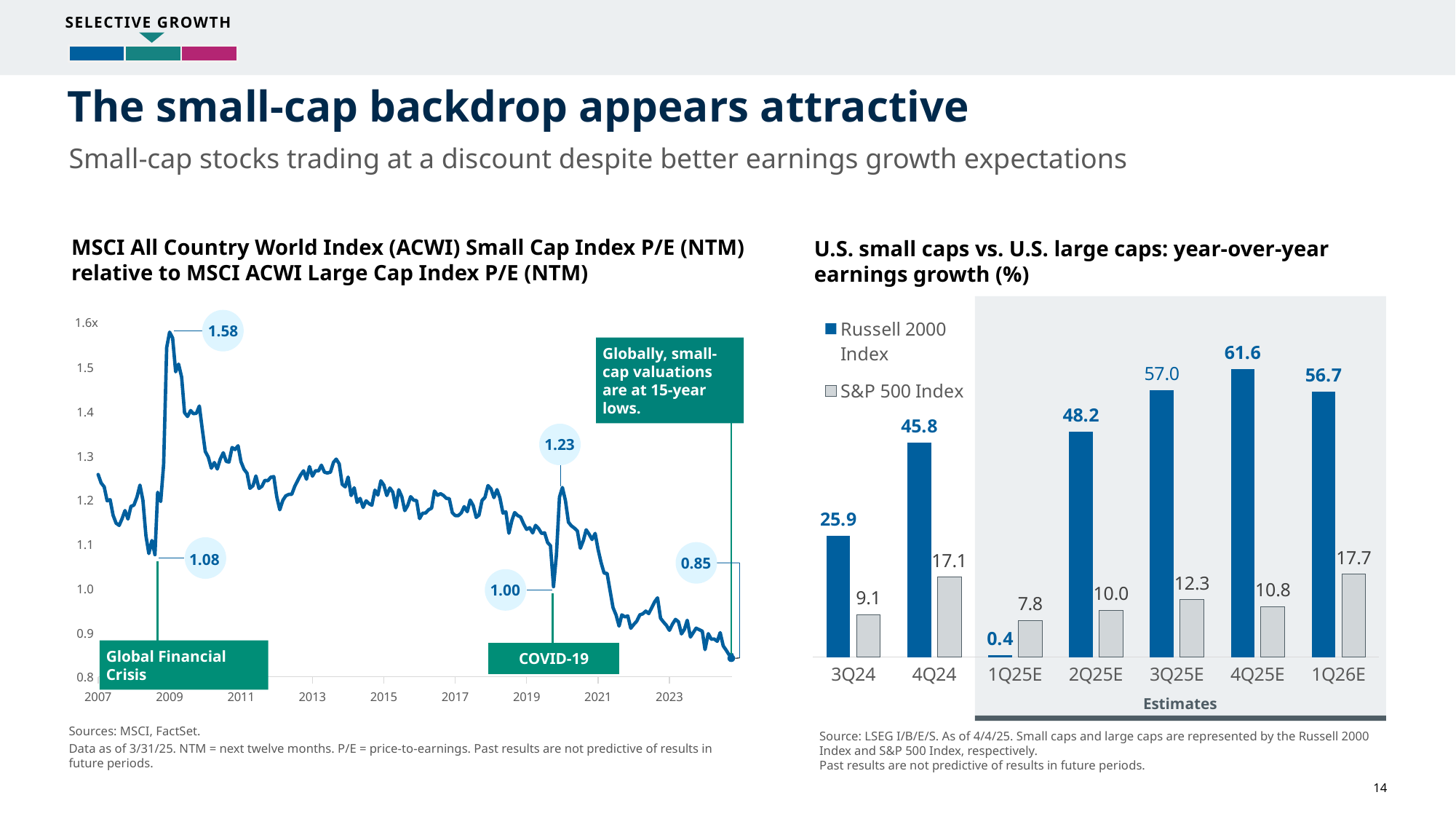
In the 'U.S. small caps vs. U.S. large caps' chart, what is the difference between the Russell 2000 Index and S&P 500 Index values for 4Q24? 28.7 In the MSCI ACWI Small Cap relative P/E chart, what is the labelled peak value reached around 2009? 1.58 In the 'U.S. small caps vs. U.S. large caps' chart, what is the Russell 2000 Index value for 4Q25E? 61.6 In the 'U.S. small caps vs. U.S. large caps' chart, which is larger for 1Q25E: the Russell 2000 Index value or the S&P 500 Index value? S&P 500 Index What kind of chart is the MSCI ACWI Small Cap relative P/E chart? Line chart What kind of chart is the 'U.S. small caps vs. U.S. large caps' chart? Bar chart In the 'U.S. small caps vs. U.S. large caps' chart, how many series does the legend list? 2 In the MSCI ACWI Small Cap relative P/E chart, what is the labelled value at the end of the series? 0.85 In the 'U.S. small caps vs. U.S. large caps' chart, which quarter has the highest Russell 2000 Index value? 4Q25E In the 'U.S. small caps vs. U.S. large caps' chart, how many quarters are shown on the x axis? 7 In the 'U.S. small caps vs. U.S. large caps' chart, what is the S&P 500 Index value for 3Q24? 9.1 In the 'U.S. small caps vs. U.S. large caps' chart, which quarter has the lowest Russell 2000 Index value? 1Q25E